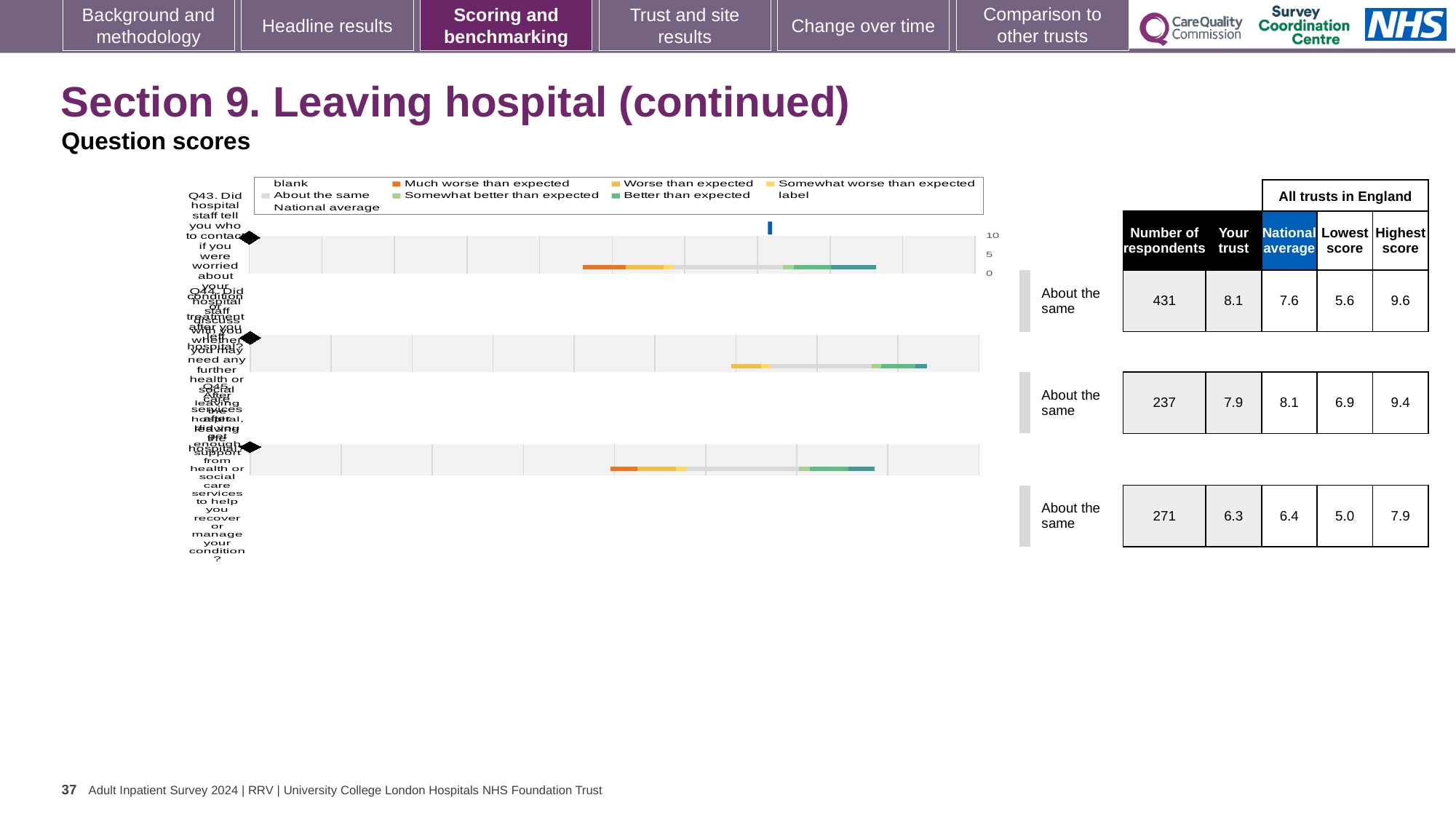
What kind of chart is used to show the question scores on this slide? bar chart For the third chart (Q45), what is the 'Your trust' score shown in the table? 6.3 In the legend, which colour represents 'Much worse than expected'? orange For the first chart (Q43), what is the national average shown in the table? 7.6 For the second chart (Q44), what is the number of respondents shown in the table? 237 Which of the three charts has the highest 'Your trust' score in the table? Q43 For the first chart (Q43), what is the 'Your trust' score shown in the table? 8.1 For the first chart (Q43), what is the difference between the highest score and the lowest score in the table? 4.0 How many question charts (rows) are shown on the slide? 3 What is the highest value shown on the x axis of the charts? 10